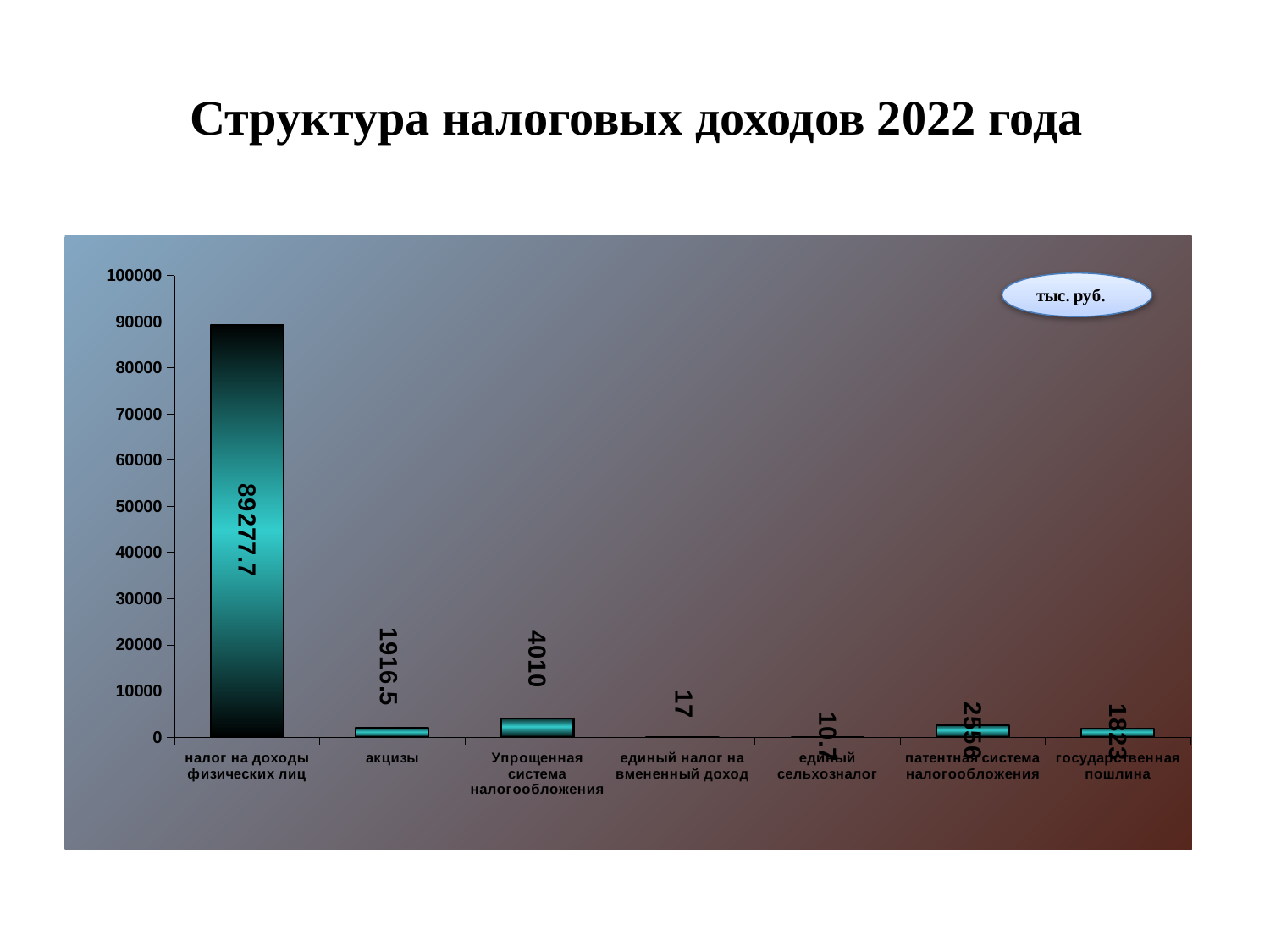
What unit of measurement is indicated on the chart? тыс. руб. What is the value for Упрощенная система налогообложения? 4010 What is the value for патентная система налогообложения? 2556 What is the value for налог на доходы физических лиц? 89277.7 Which category has the highest value? налог на доходы физических лиц Which category has the lowest value? единый сельхозналог What is the value for единый сельхозналог? 10.7 What kind of chart is shown on the slide? bar chart How many categories are shown on the chart? 7 What is the value for акцизы? 1916.5 Which is larger, the value for акцизы or the value for государственная пошлина? акцизы What is the difference between the values for Упрощенная система налогообложения and патентная система налогообложения? 1454